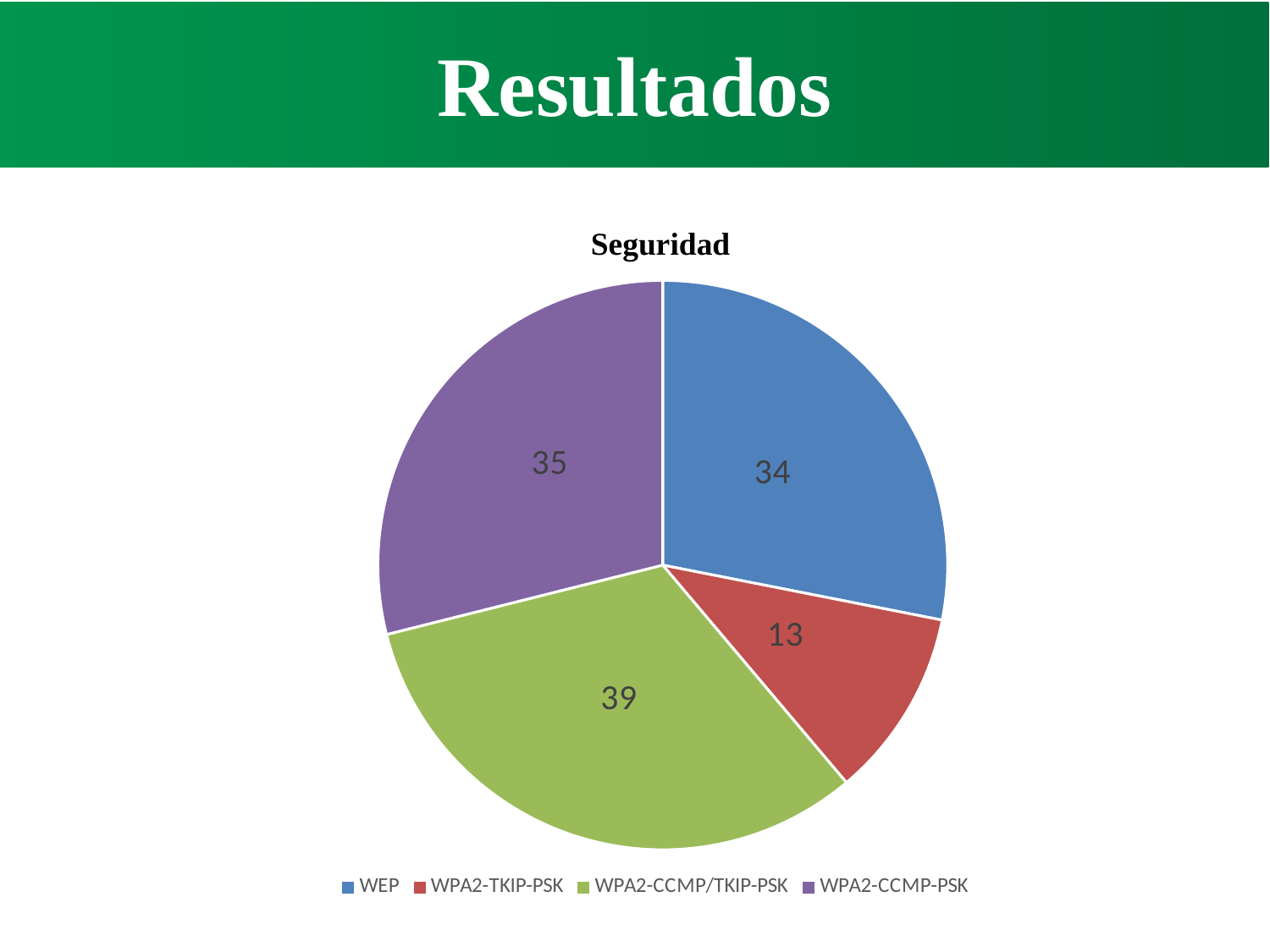
What is the value for WEP? 34 How many categories does the pie chart have? 4 What is the value for WPA2-CCMP-PSK? 35 Which is larger, the value for WPA2-CCMP-PSK or the value for WEP? WPA2-CCMP-PSK Which category has the largest slice? WPA2-CCMP/TKIP-PSK What is the value for WPA2-CCMP/TKIP-PSK? 39 What is the difference between the values for WPA2-CCMP/TKIP-PSK and WPA2-TKIP-PSK? 26 What is the title of the chart? Seguridad What is the value for WPA2-TKIP-PSK? 13 What is the total of all the slices in the pie chart? 121 What type of chart is shown on the slide? pie chart Which category has the smallest slice? WPA2-TKIP-PSK